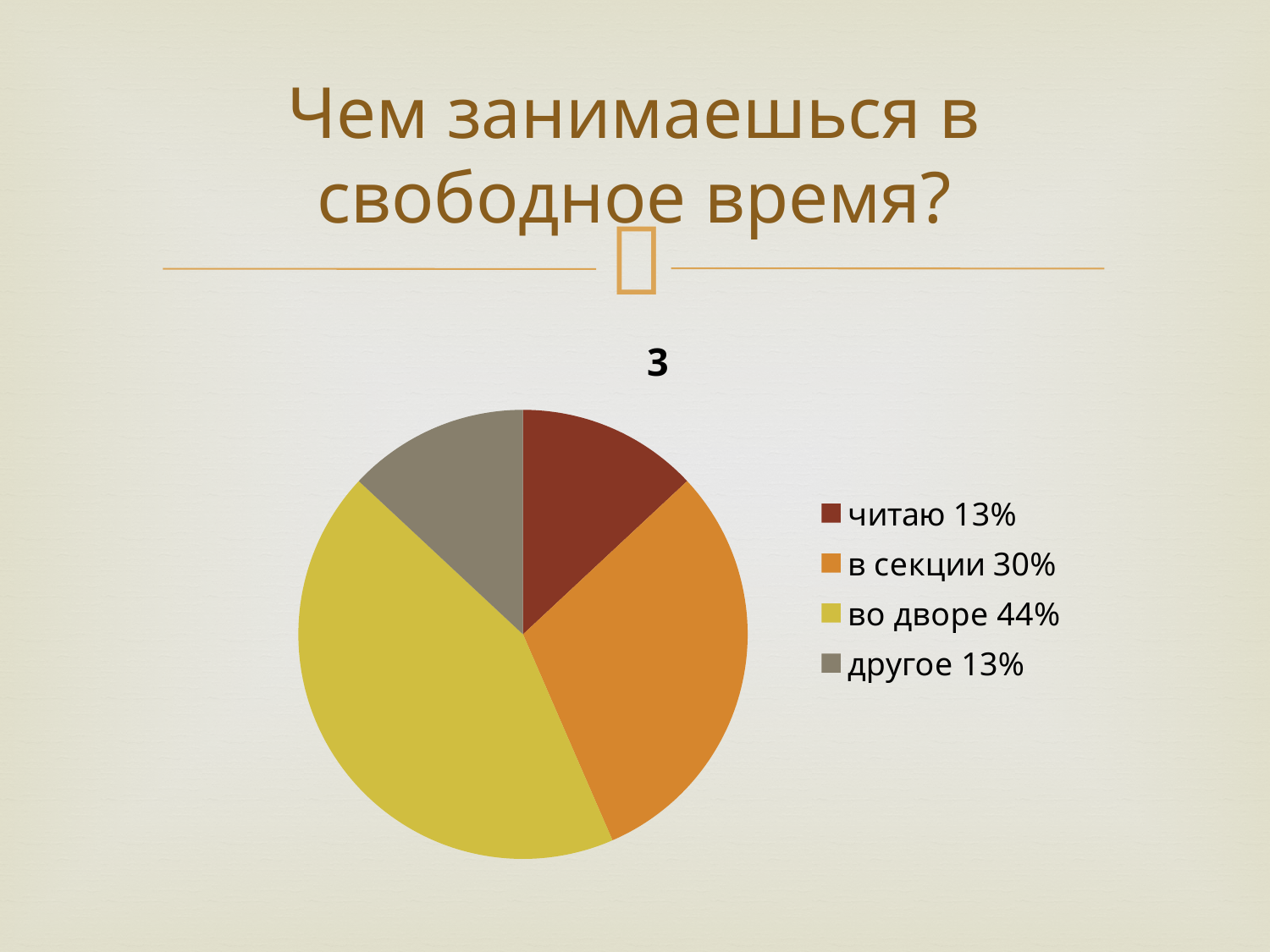
What is the difference in percentage points between "в секции" and "читаю"? 17 What colour is the slice for "во дворе"? yellow Which is larger, the share for "в секции" or the share for "другое"? в секции What percentage is shown for "в секции" in the legend? 30% Which two categories have the same percentage in the legend? читаю and другое What kind of chart is shown on the slide? pie chart Which category has the largest share of the pie? во дворе How many slices does the pie chart have? 4 What is the difference in percentage points between "во дворе" and "в секции"? 14 What percentage is shown for "читаю" in the legend? 13% What is the title shown above the pie chart? 3 What percentage is shown for "во дворе" in the legend? 44%